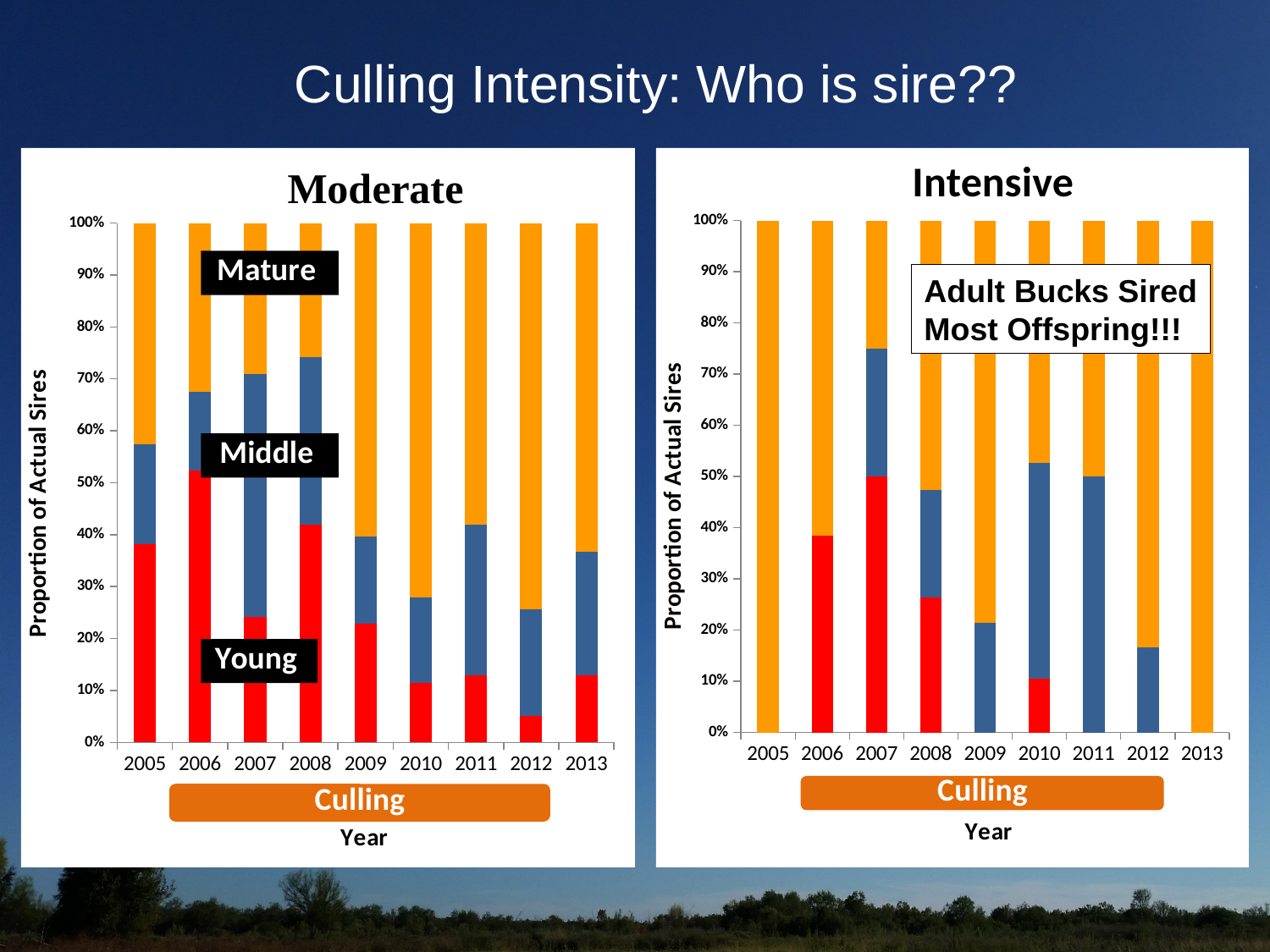
In the Moderate chart, which year has the largest Young share? 2006 In the Intensive chart, which year has the smallest Mature share? 2007 In the Intensive chart, what proportion of sires were Young in 2011? 0% In the Moderate chart, does the Young share generally rise or fall from 2005 to 2013? fall In the Moderate chart, which year has the larger Young share, 2009 or 2012? 2009 What is the y-axis title of the Intensive chart? Proportion of Actual Sires How many years are shown on the x axis of the Intensive chart? 9 What kind of chart is the Moderate chart? stacked bar chart In the Moderate chart, is the Young share in 2005 greater or less than 30%? greater In the Moderate chart, what is the total height of the stacked bar for 2008? 100% In the Intensive chart, what proportion of sires were Mature in 2005? 100% What are the three age classes labelled on the Moderate chart? Young, Middle, Mature